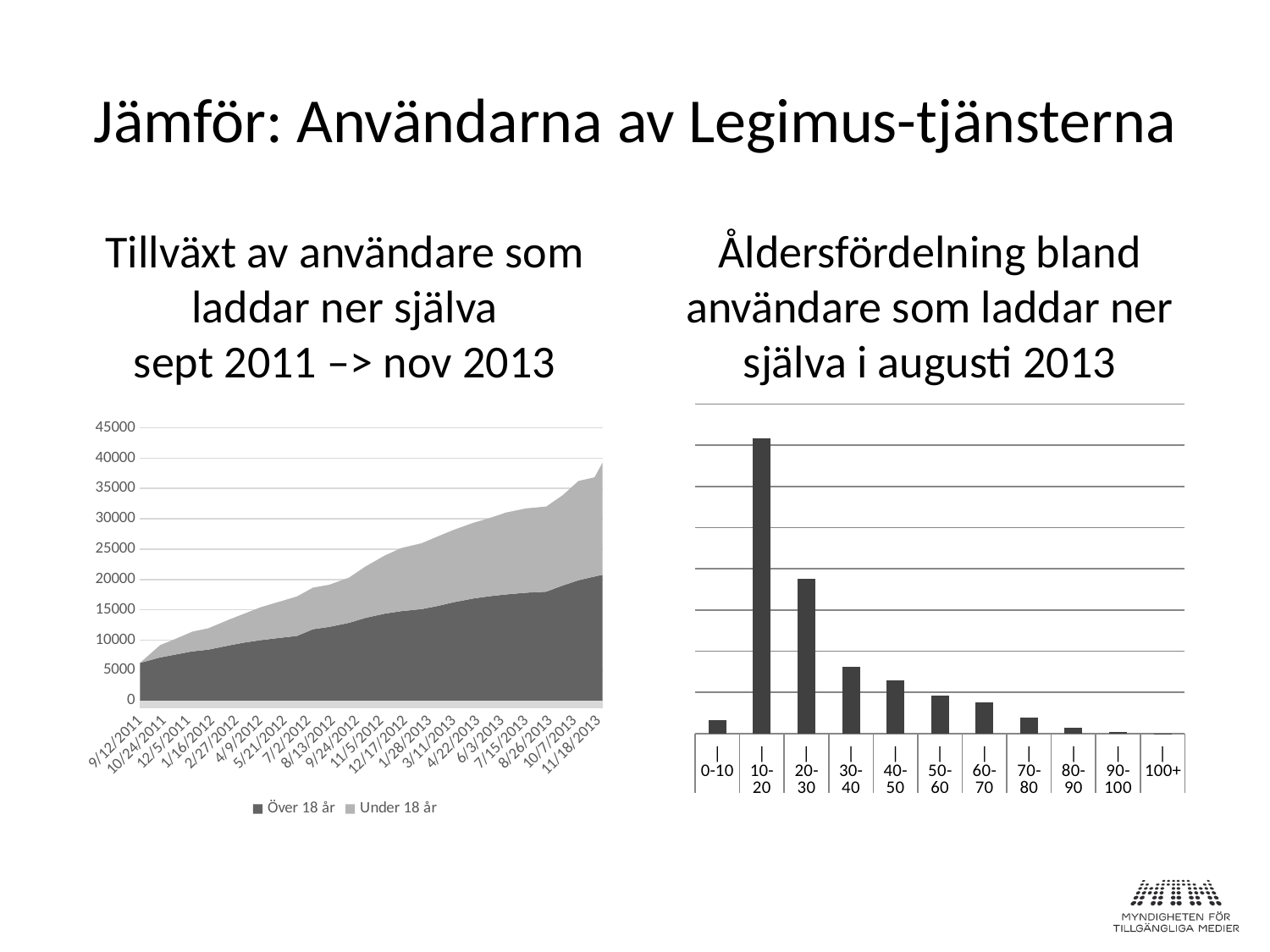
In the left chart, what is the first date shown on the x axis? 9/12/2011 In the right chart, which is larger, the bar for 20-30 or the bar for 30-40? 20-30 In the right chart, how many age categories are shown on the x axis? 11 What kind of chart is the left chart, 'Tillväxt av användare som laddar ner själva'? Stacked area chart In the left chart, is the total stacked value at 11/18/2013 greater or less than 35000? greater In the left chart, is the value for Över 18 år at 11/18/2013 greater or less than 25000? less In the left chart, what are the two series named in the legend? Över 18 år and Under 18 år What kind of chart is the right chart, 'Åldersfördelning bland användare som laddar ner själva i augusti 2013'? Bar chart In the right chart, which is larger, the bar for 40-50 or the bar for 60-70? 40-50 In the left chart, how many series does the legend list? 2 In the left chart, do the total values rise or fall from 9/12/2011 to 11/18/2013? Rise In the right chart, which age group has the highest bar? 10-20